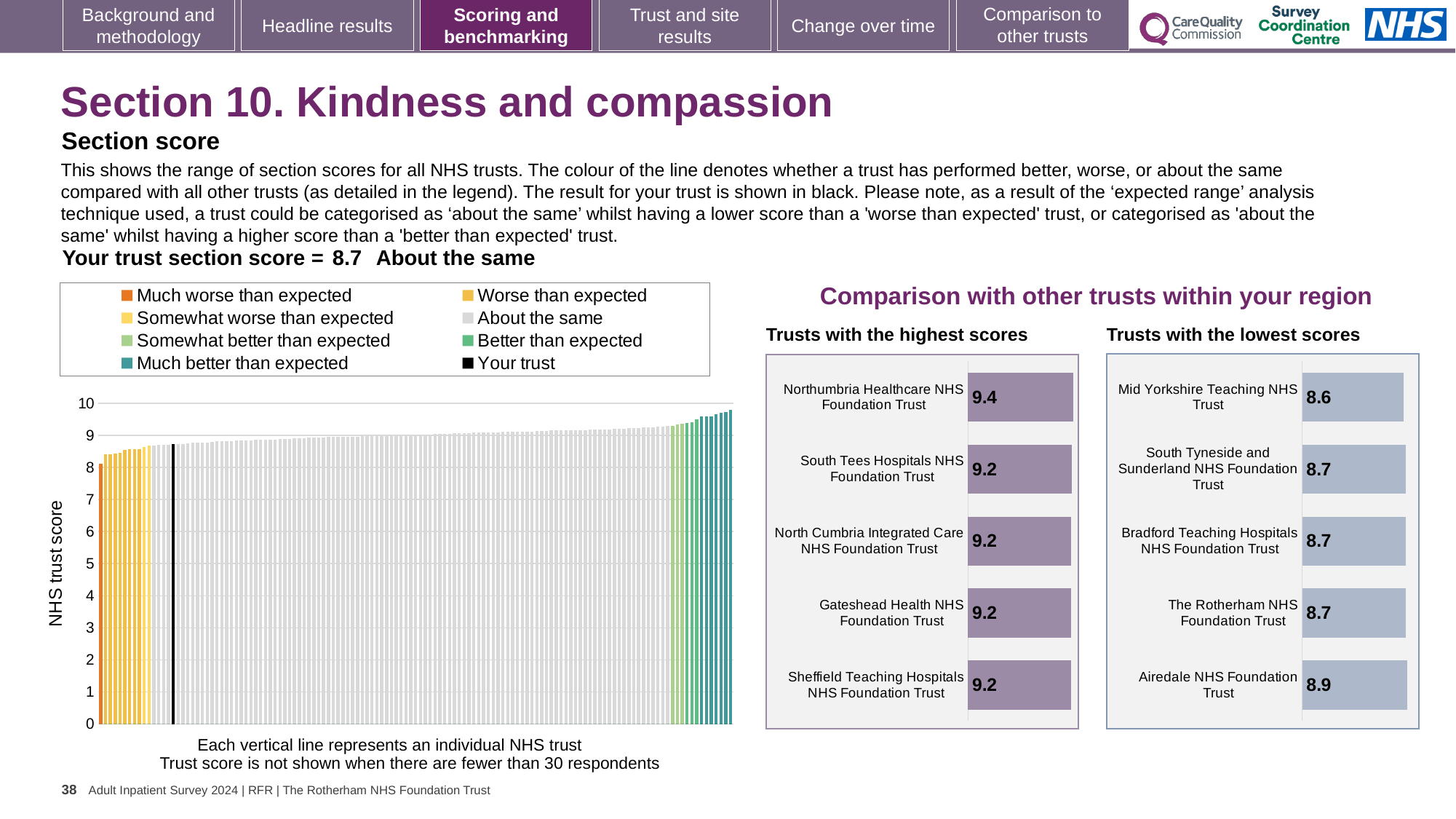
In the 'Trusts with the highest scores' chart, what is the score for Northumbria Healthcare NHS Foundation Trust? 9.4 In the 'Trusts with the lowest scores' chart, what is the difference between the scores of Airedale NHS Foundation Trust and Mid Yorkshire Teaching NHS Trust? 0.3 In the 'Trusts with the highest scores' chart, which trust has the highest score? Northumbria Healthcare NHS Foundation Trust How many entries does the legend of the large chart on the left list? 8 How many trusts are shown in the 'Trusts with the highest scores' chart? 5 In the 'Trusts with the lowest scores' chart, which trust has the lowest score? Mid Yorkshire Teaching NHS Trust In the 'Trusts with the lowest scores' chart, what is the score for Airedale NHS Foundation Trust? 8.9 What kind of chart is the 'Trusts with the lowest scores' chart? Bar chart In the 'Trusts with the highest scores' chart, what is the difference between the scores of Northumbria Healthcare NHS Foundation Trust and South Tees Hospitals NHS Foundation Trust? 0.2 In the 'Trusts with the lowest scores' chart, what is the score for Mid Yorkshire Teaching NHS Trust? 8.6 In the large chart on the left showing all NHS trusts, is the value for the black 'Your trust' bar greater or less than 5? greater In the 'Trusts with the lowest scores' chart, which has the larger score: Airedale NHS Foundation Trust or Bradford Teaching Hospitals NHS Foundation Trust? Airedale NHS Foundation Trust